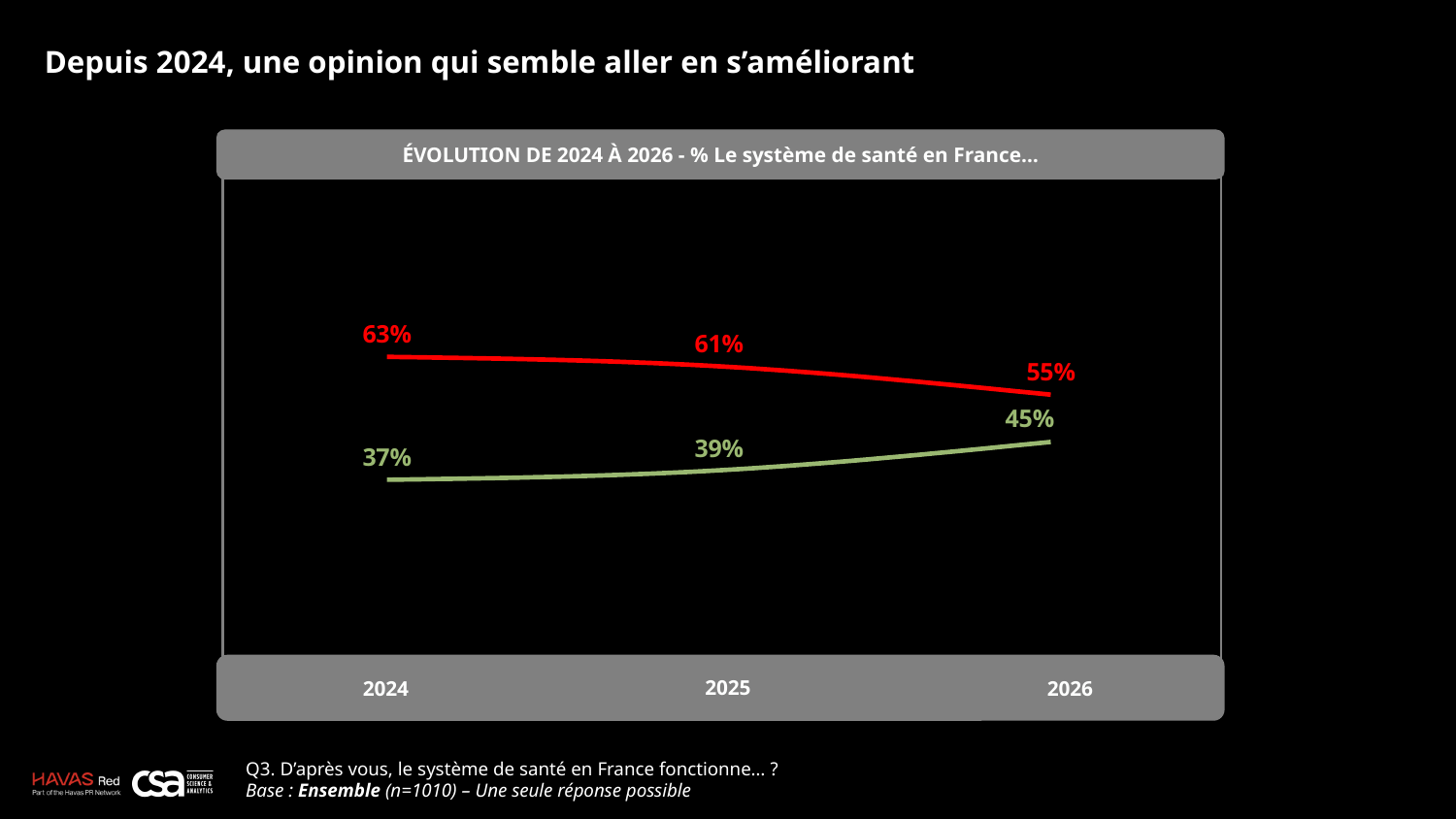
What is the difference between the red line and the green line in 2026? 10% In which year is the red line at its lowest value? 2026 How many years are shown on the x axis? 3 What is the value of the red line in 2025? 61% In which year is the green line at its highest value? 2026 What is the value of the green line in 2026? 45% By how much does the red line fall from 2024 to 2026? 8% Which is larger in 2025, the red line or the green line? the red line What kind of chart is shown on the slide? line chart What is the value of the red line in 2024? 63% What is the value of the green line in 2024? 37% Does the green line rise or fall from 2024 to 2026? rise